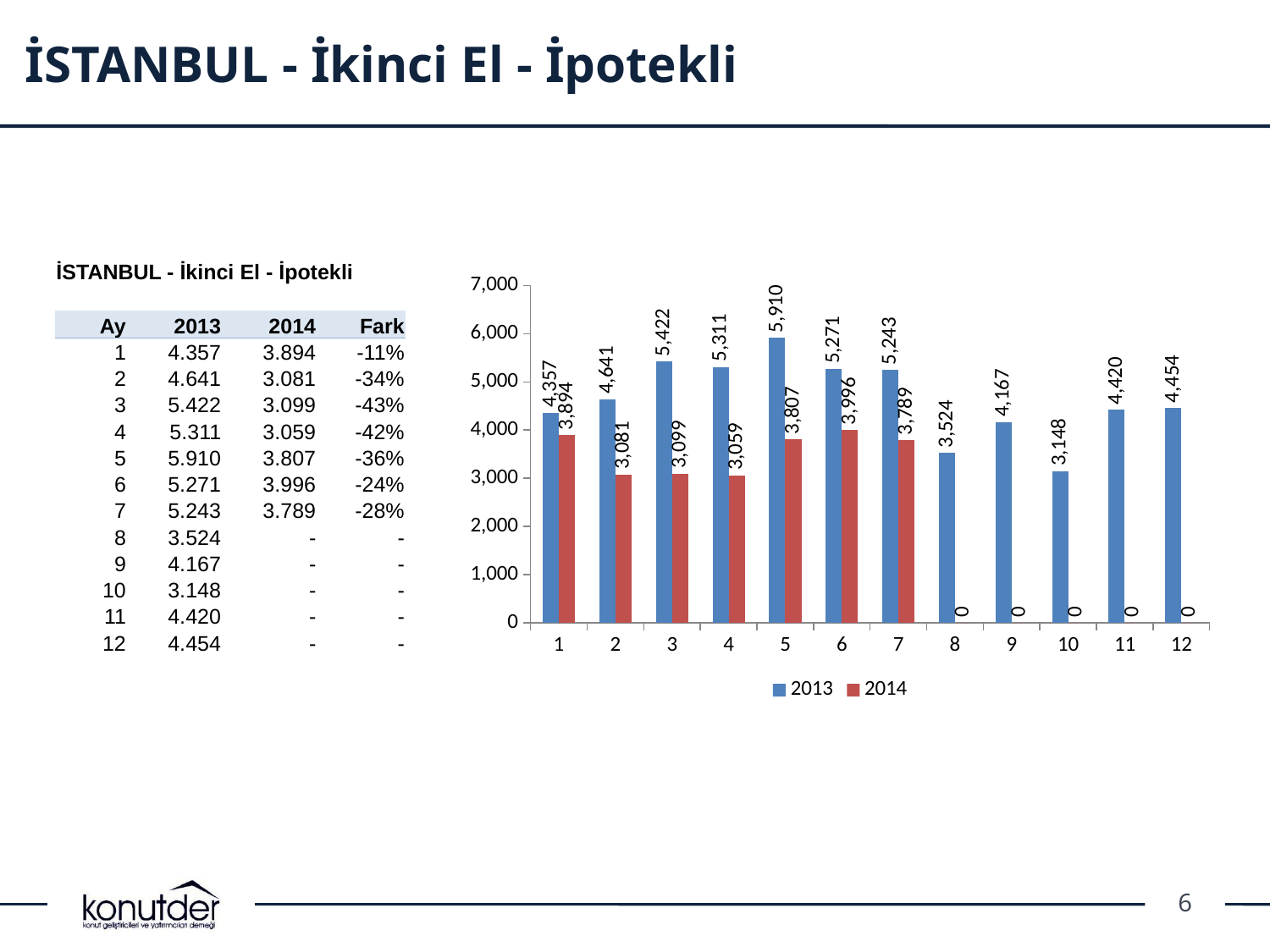
How many series does the chart legend list? 2 Which is larger for month 1: the 2013 value or the 2014 value? 2013 Which month has the lowest 2013 value in the chart? 10 What is the 2013 value for month 5 in the chart? 5,910 What is the 2014 value shown for month 12 in the chart? 0 Which month has the highest 2013 value in the chart? 5 How many months are shown on the x axis of the chart? 12 What is the 2014 value for month 2 in the chart? 3,081 What is the difference between the 2013 and 2014 values for month 3? 2,323 Is the 2013 value for month 8 greater or less than 4,000? less Among months 1 to 7, which month has the lowest 2014 value? 4 What type of chart is shown on the slide? bar chart